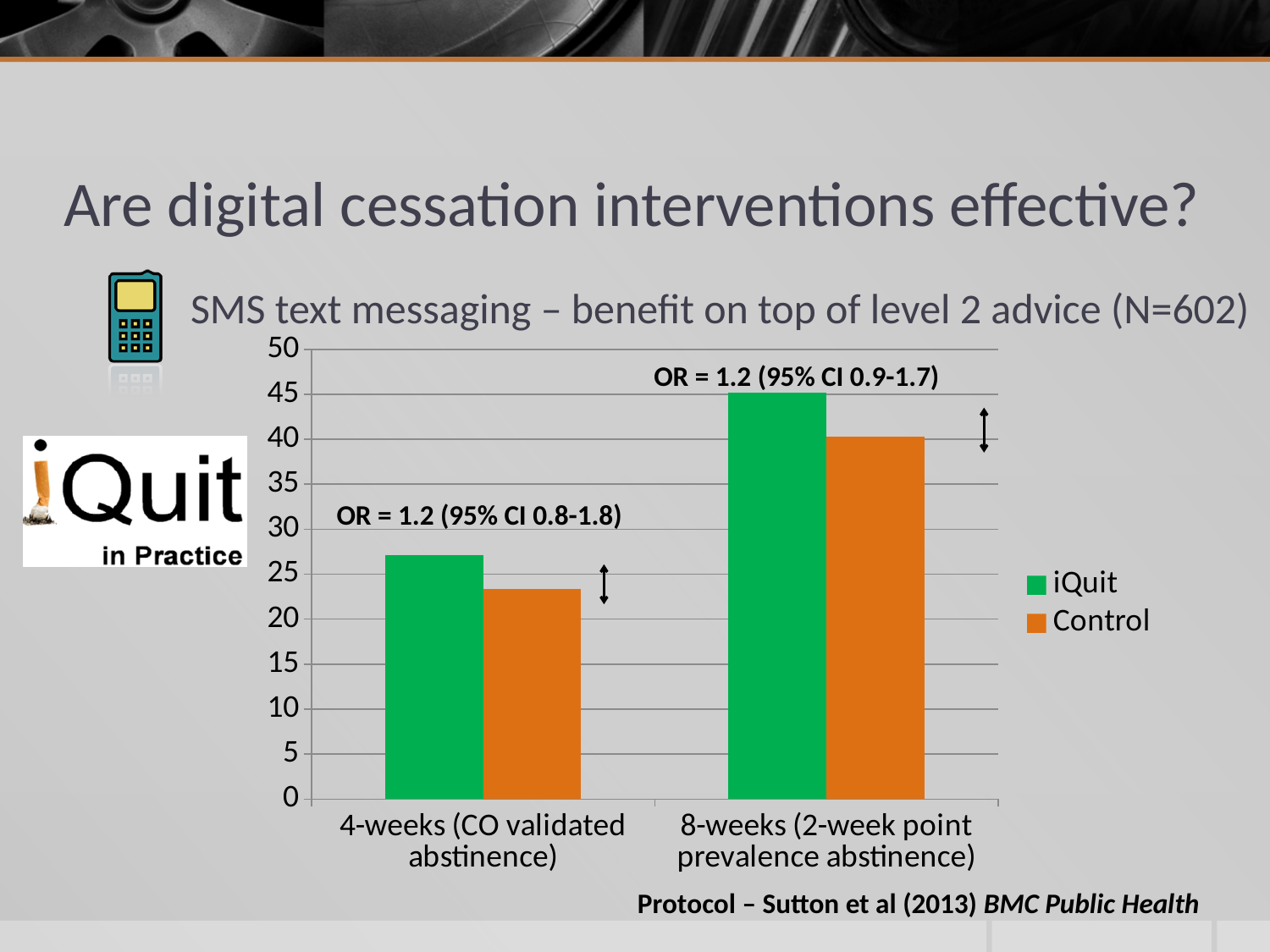
How many categories are shown on the x axis of the chart? 2 Which series is higher for the 4-weeks (CO validated abstinence) category, iQuit or Control? iQuit Which series is higher for the 8-weeks (2-week point prevalence abstinence) category, iQuit or Control? iQuit Is the iQuit value for 4-weeks (CO validated abstinence) greater or less than 30? less Is the iQuit value for 8-weeks (2-week point prevalence abstinence) greater or less than 40? greater Is the Control value for 8-weeks (2-week point prevalence abstinence) greater or less than 45? less Do the iQuit values rise or fall from the 4-weeks category to the 8-weeks category? rise How many series does the chart legend list? 2 What kind of chart is shown on the slide? bar chart What odds ratio annotation is shown above the 8-weeks (2-week point prevalence abstinence) bars? OR = 1.2 (95% CI 0.9-1.7) Which category has the highest iQuit bar? 8-weeks (2-week point prevalence abstinence)